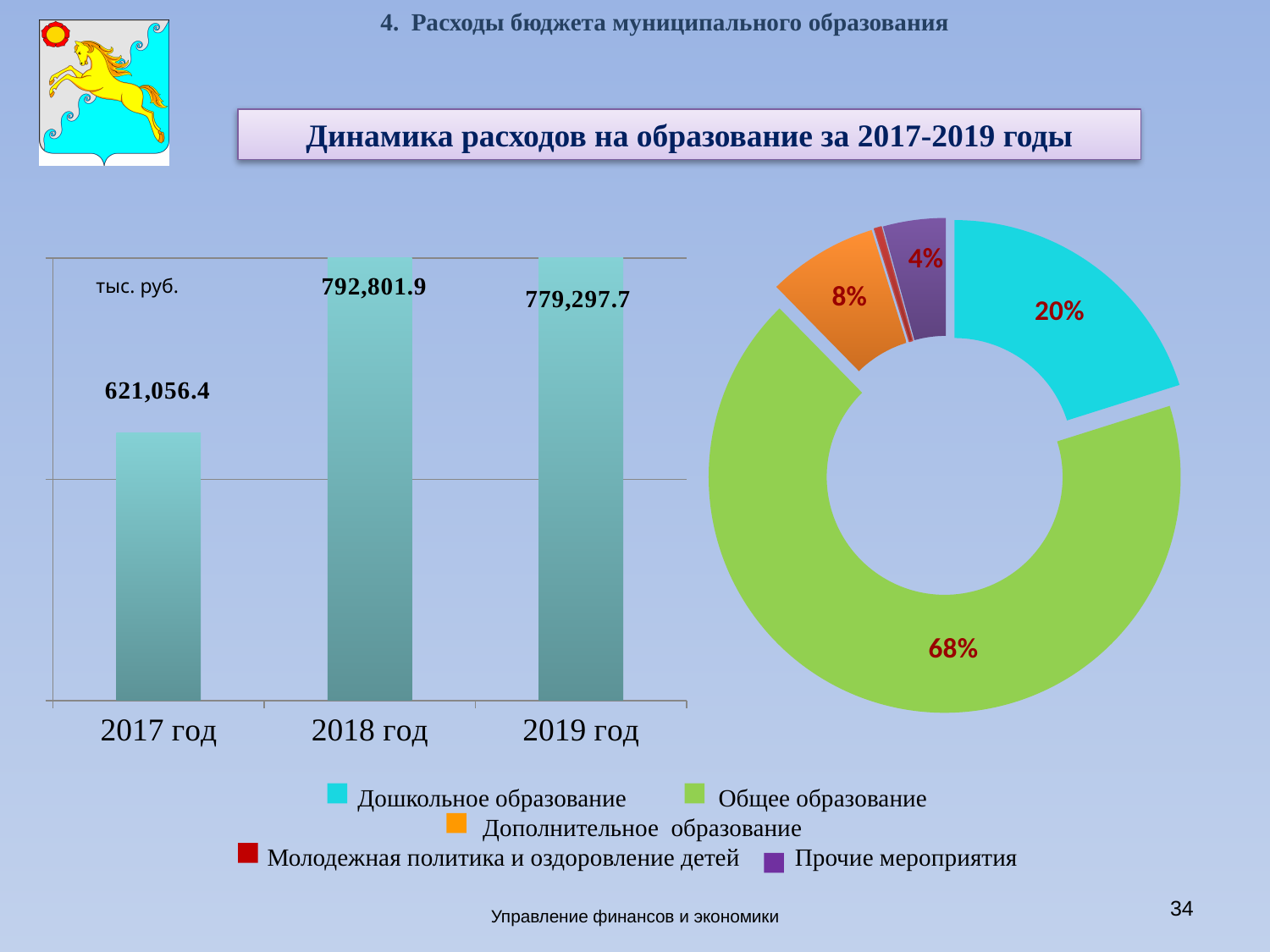
On the bar chart on the left, which year has the highest value? 2018 год On the bar chart on the left, what is the difference between the values for 2018 год and 2017 год? 171,745.5 On the donut chart on the right, what share does Дошкольное образование have? 20% On the bar chart on the left, what is the value for 2018 год? 792,801.9 On the bar chart on the left, what is the value for 2019 год? 779,297.7 On the bar chart on the left, which year has the lowest value? 2017 год On the bar chart on the left, what is the value for 2017 год? 621,056.4 What type of chart is the chart on the left of the slide? Bar chart On the donut chart on the right, what share does Общее образование have? 68% On the donut chart on the right, which category has the largest share? Общее образование On the bar chart on the left, what is the difference between the values for 2018 год and 2019 год? 13,504.2 On the bar chart on the left, how many years are shown? 3